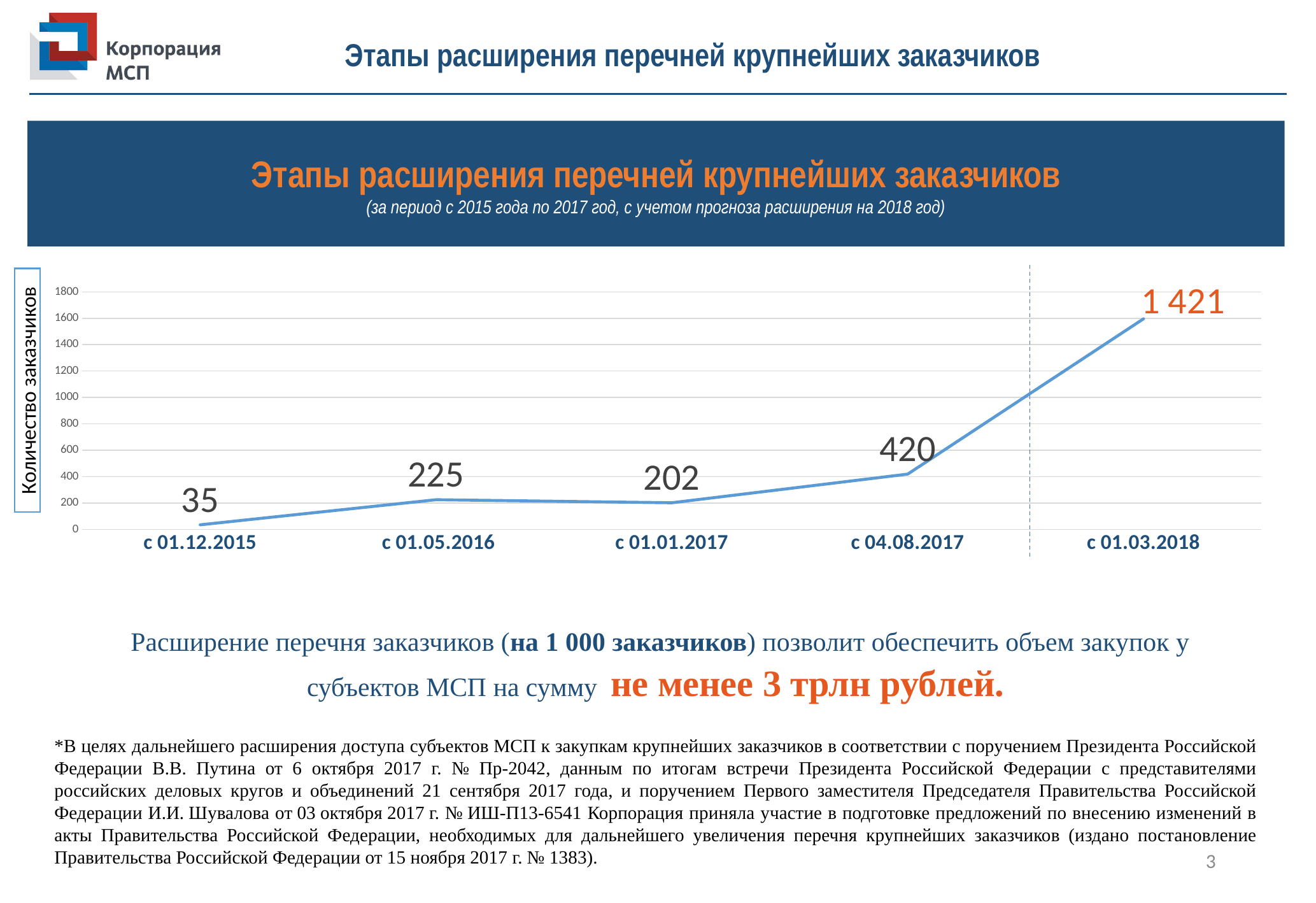
What is the value plotted for с 01.05.2016? 225 What type of chart is shown on the slide? Line chart What is the number of customers (Количество заказчиков) for с 01.12.2015? 35 What is the value plotted for с 01.03.2018? 1 421 Which is larger, the value for с 01.05.2016 or the value for с 01.01.2017? с 01.05.2016 What is the difference between the values for с 01.03.2018 and с 04.08.2017? 1 001 How many data points are plotted on the line chart? 5 Which date has the lowest value on the chart? с 01.12.2015 Which date has the highest value on the chart? с 01.03.2018 What is the value plotted for с 01.01.2017? 202 What is the label of the vertical axis of the chart? Количество заказчиков What is the value plotted for с 04.08.2017? 420